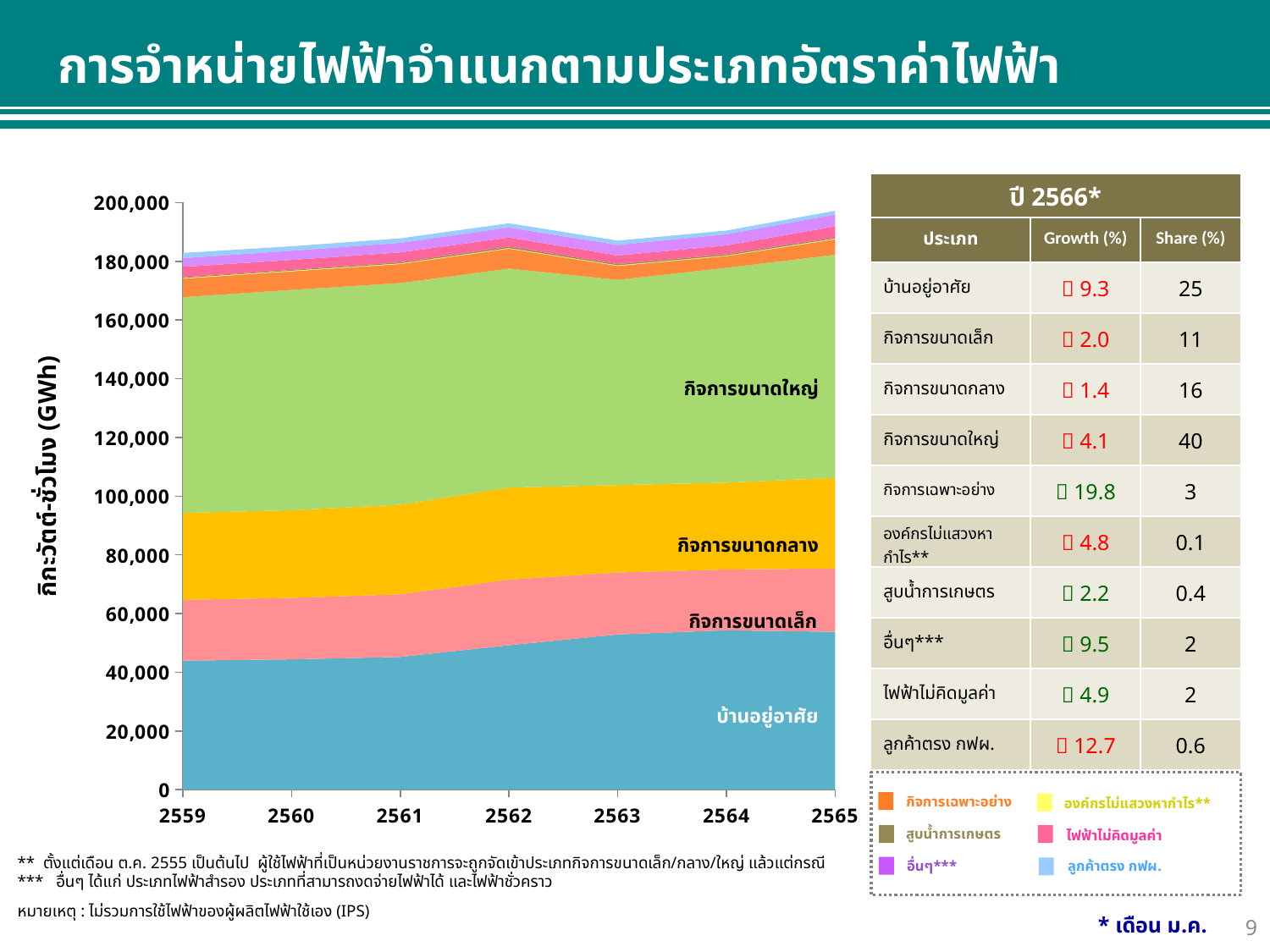
Is the total stacked value for 2559 greater or less than 160,000? greater How many entries does the legend box at the bottom right of the chart list? 6 What kind of chart is shown on the slide? stacked area chart Is the value for บ้านอยู่อาศัย in 2559 greater or less than 60,000? less Is the total stacked value for 2565 greater or less than 200,000? less How many years are shown along the x axis of the chart? 7 Does the value for บ้านอยู่อาศัย rise or fall from 2559 to 2565? rises Which series occupies the largest band in the chart? กิจการขนาดใหญ่ What is the last year shown on the x axis of the chart? 2565 What is the first year shown on the x axis of the chart? 2559 Does the total stacked value rise or fall from 2562 to 2563? falls Which is larger, the value for บ้านอยู่อาศัย in 2565 or in 2559? 2565